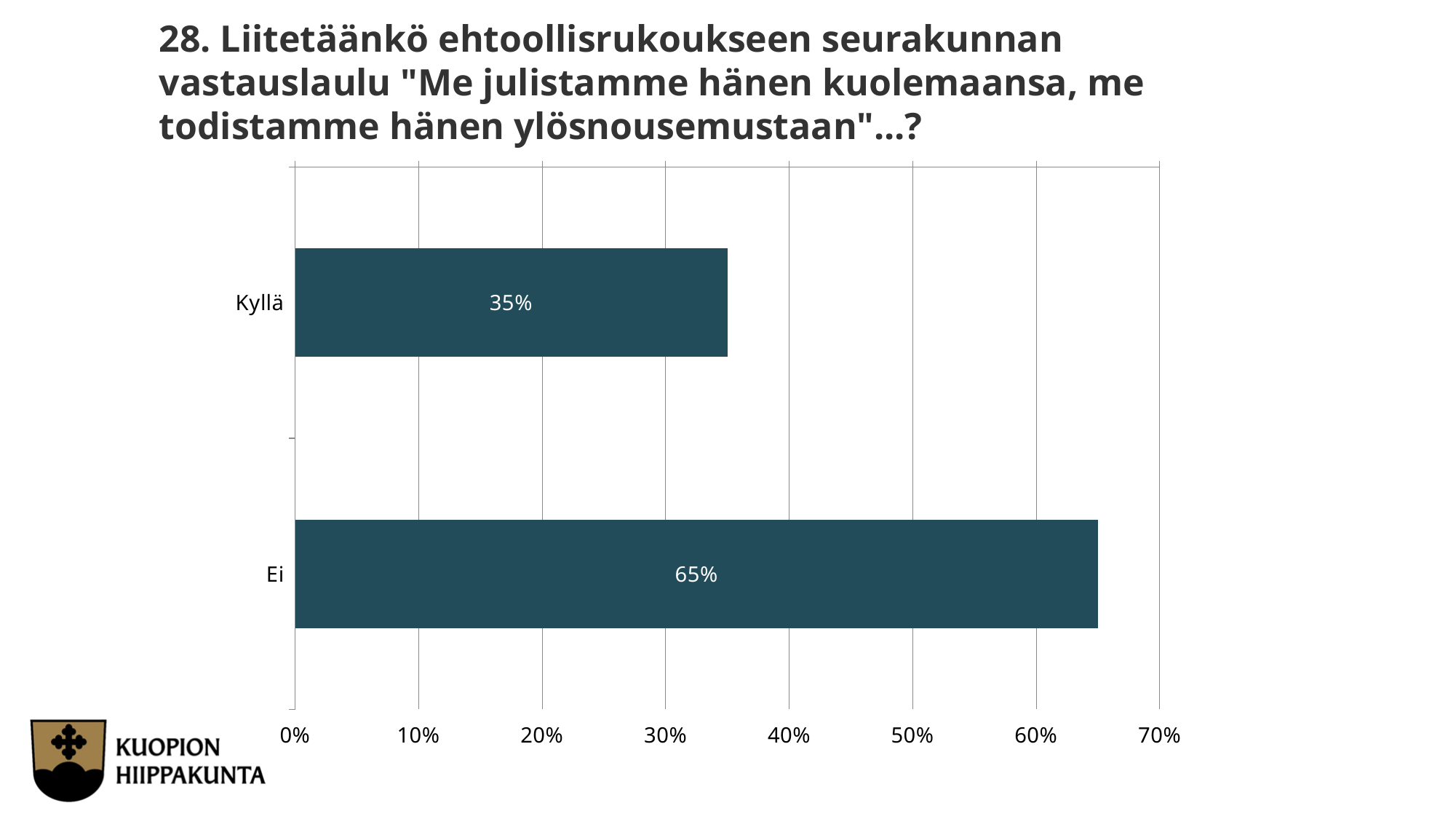
What is the total of the values for Kyllä and Ei? 100% What is the value for Kyllä? 35% How many categories are shown in the chart? 2 Is the value for Kyllä greater or less than 40%? less Is the value for Ei greater or less than 60%? greater What is the value for Ei? 65% What kind of chart is shown on the slide? bar chart What is the maximum value shown on the horizontal axis? 70% Which category has the highest value? Ei Which category has the lowest value? Kyllä What is the difference between the values for Ei and Kyllä? 30% Which is larger, the value for Kyllä or the value for Ei? Ei